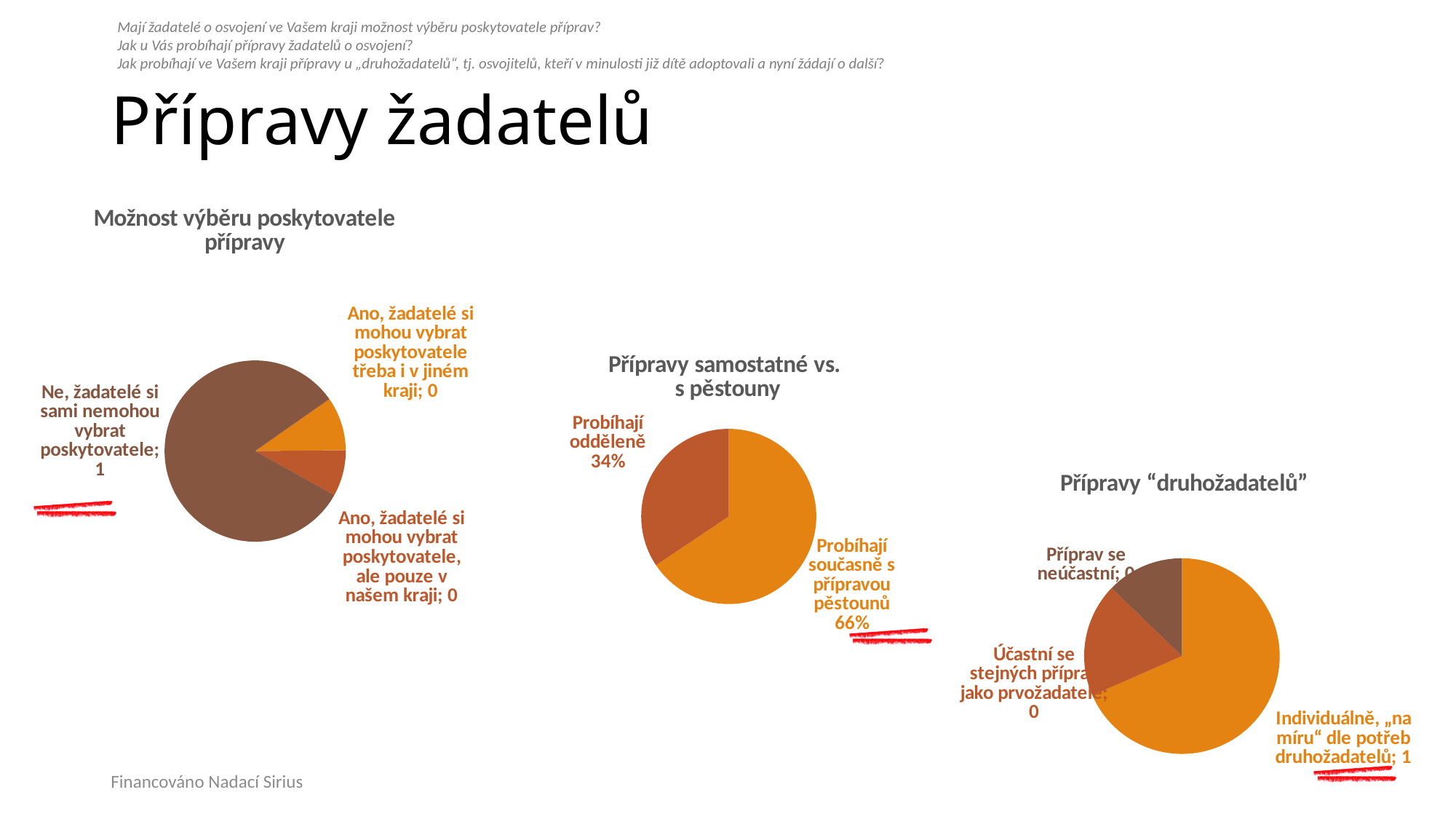
In the chart titled "Možnost výběru poskytovatele přípravy", what value is labelled for "Ne, žadatelé si sami nemohou vybrat poskytovatele"? 1 In the chart titled "Přípravy samostatné vs. s pěstouny", what is the difference in percentage points between the two slices? 32 percentage points In the chart titled "Přípravy “druhožadatelů”", which category has the largest slice? Individuálně, „na míru“ dle potřeb druhožadatelů What kind of chart is the chart titled "Přípravy samostatné vs. s pěstouny"? pie chart How many slices does the chart titled "Přípravy samostatné vs. s pěstouny" have? 2 In the chart titled "Možnost výběru poskytovatele přípravy", which category has the largest slice? Ne, žadatelé si sami nemohou vybrat poskytovatele In the chart titled "Přípravy samostatné vs. s pěstouny", what share is labelled for "Probíhají současně s přípravou pěstounů"? 66% In the chart titled "Přípravy samostatné vs. s pěstouny", what share is labelled for "Probíhají odděleně"? 34% How many slices does the chart titled "Možnost výběru poskytovatele přípravy" have? 3 In the chart titled "Přípravy samostatné vs. s pěstouny", which slice is larger: "Probíhají odděleně" or "Probíhají současně s přípravou pěstounů"? Probíhají současně s přípravou pěstounů How many pie charts are shown on the slide? 3 How many slices does the chart titled "Přípravy “druhožadatelů”" have? 3